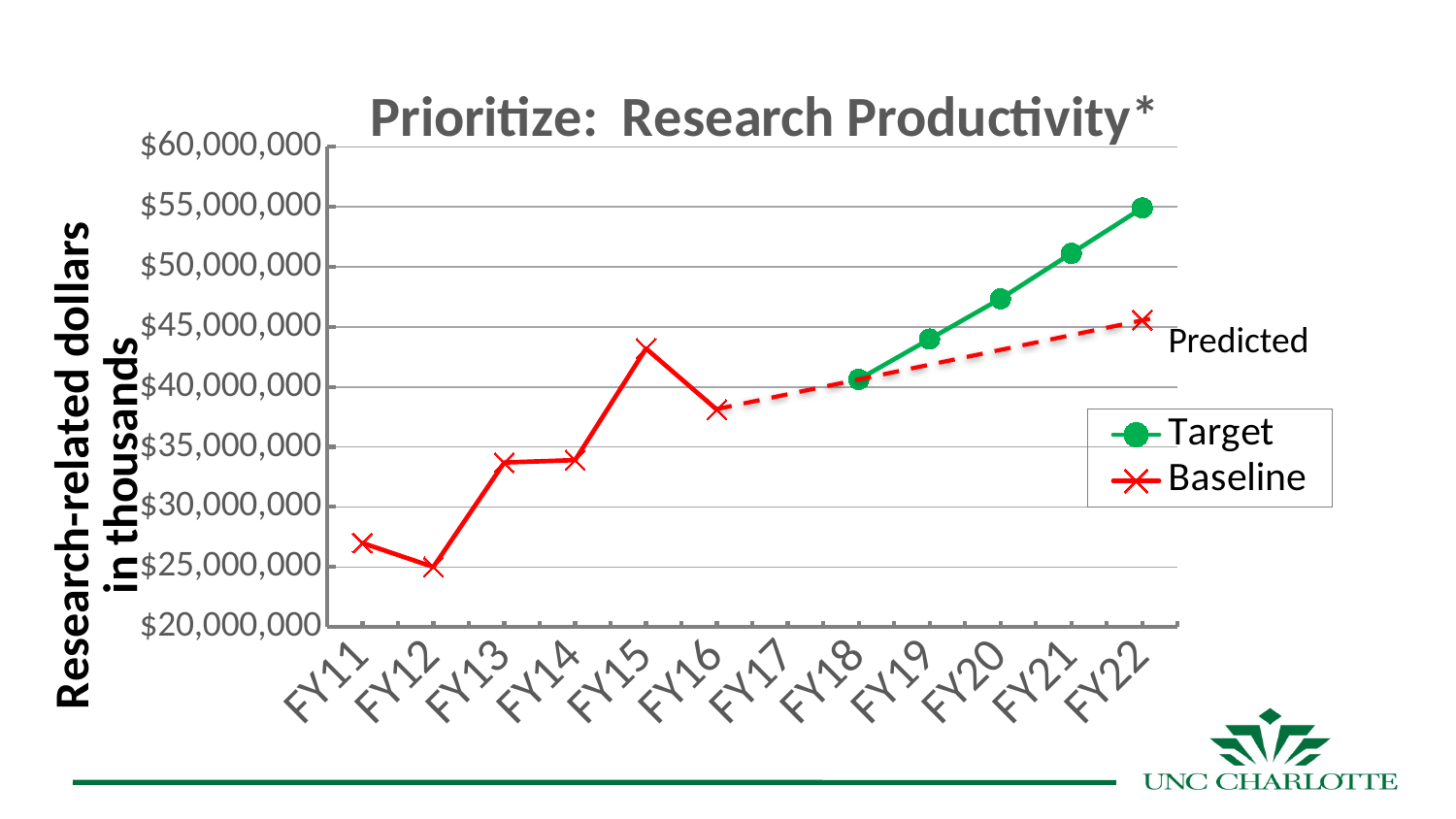
Is the Target value for FY22 greater or less than $50,000,000? greater Is the Baseline value for FY22 greater or less than $50,000,000? less In which fiscal year is the Baseline series at its lowest? FY12 For FY22, which is larger, the Target value or the Baseline value? Target Is the Baseline value for FY12 greater or less than $30,000,000? less How many fiscal years are labelled on the x axis? 12 In which fiscal year does the Target series reach its highest value? FY22 What is the label on the vertical axis? Research-related dollars in thousands What kind of chart is shown on the slide? line chart What is the title of the chart? Prioritize: Research Productivity* How many series does the legend list? 2